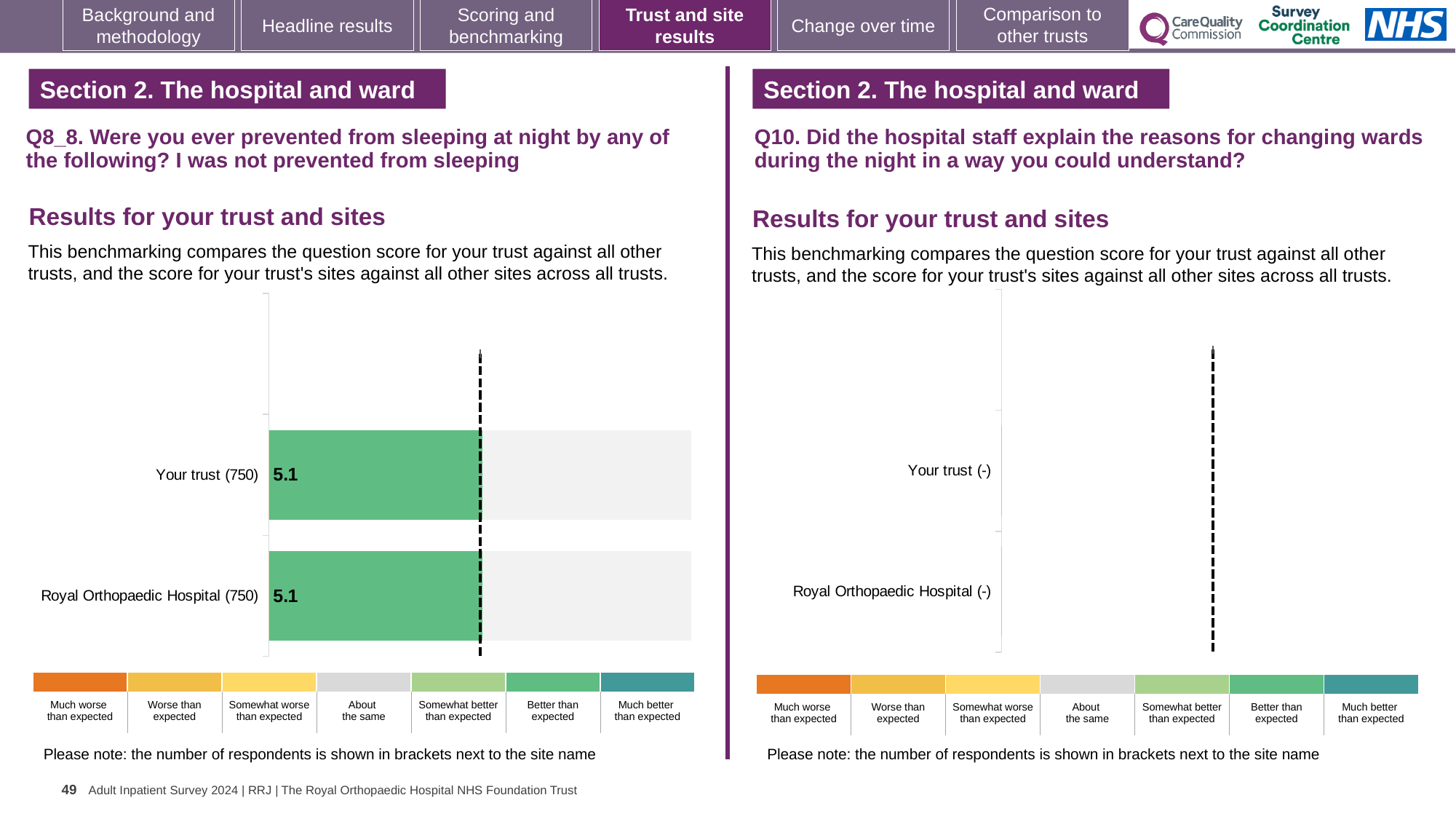
In the left chart (Q8_8), is the score for Your trust the same as the score for Royal Orthopaedic Hospital? Yes In the left chart (Q8_8), how many bars are plotted? 2 In the left chart (Q8_8), how many respondents are shown in brackets next to Your trust? 750 In the left chart (Q8_8), what is the score for Your trust? 5.1 What kind of chart is the left chart (Q8_8)? Bar chart In the left chart (Q8_8), what is the difference between the score for Your trust and the score for Royal Orthopaedic Hospital? 0 In the right chart (Q10), what is shown in brackets next to Your trust? - In the left chart (Q8_8), what colour are the bars for Your trust and Royal Orthopaedic Hospital? Green In the left chart (Q8_8), what is the score for Royal Orthopaedic Hospital? 5.1 In the right chart (Q10), how many categories are listed on the vertical axis? 2